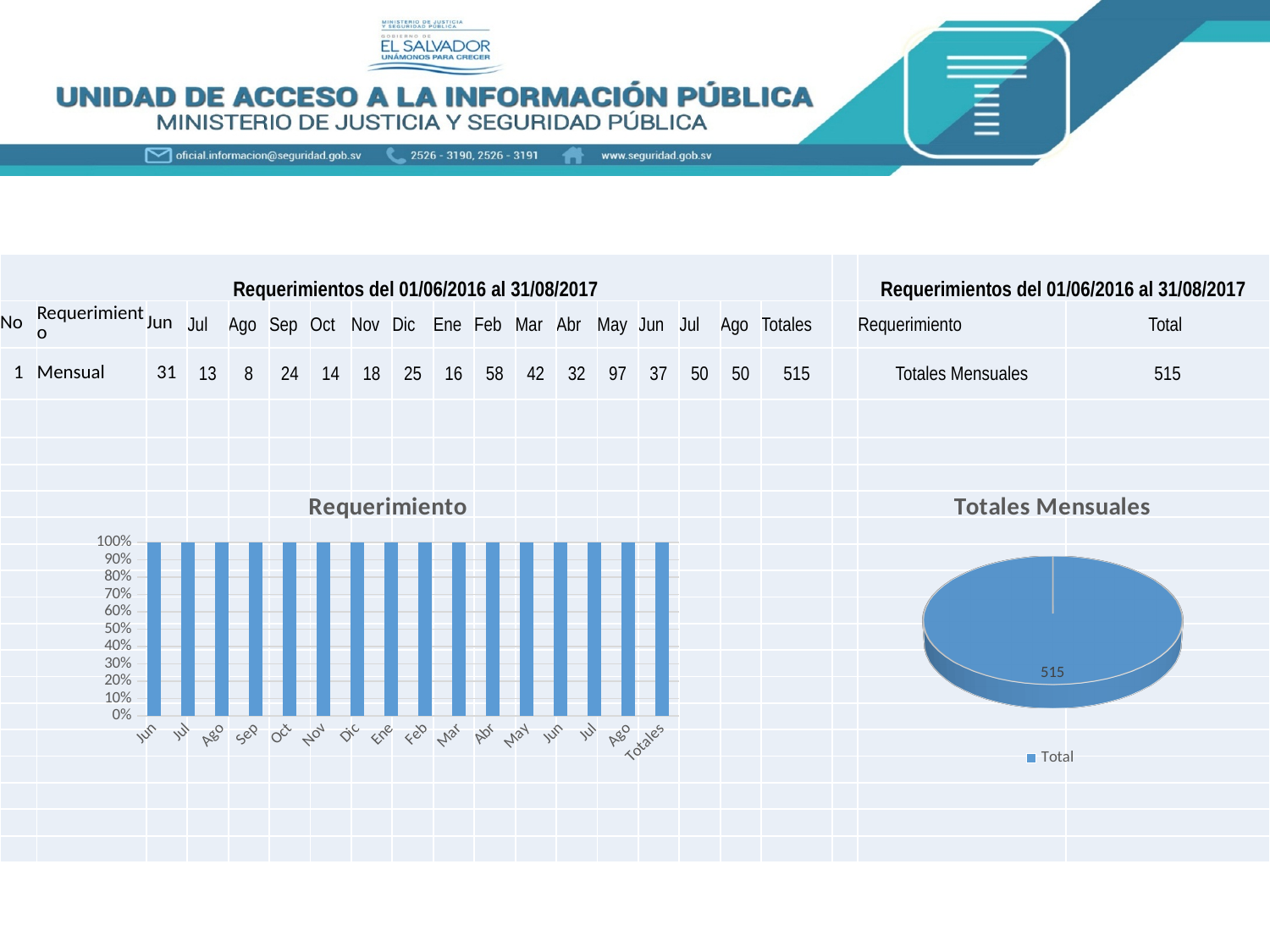
In the chart titled "Requerimiento", what is the highest value shown on the y axis? 100% In the chart titled "Totales Mensuales", what value is printed on the pie slice? 515 What kind of chart is the chart titled "Totales Mensuales"? pie chart What is the first category on the x axis of the chart titled "Requerimiento"? Jun In the chart titled "Requerimiento", is the value for Jun greater or less than 50%? greater How many slices does the pie chart titled "Totales Mensuales" have? 1 In the chart titled "Requerimiento", is the value for Totales greater or less than 90%? greater In the chart titled "Totales Mensuales", what share of the pie does the slice labelled 515 represent? 100% How many categories are shown on the x axis of the chart titled "Requerimiento"? 16 How many series does the legend of the chart titled "Totales Mensuales" list? 1 What is the legend entry of the chart titled "Totales Mensuales"? Total What kind of chart is the chart titled "Requerimiento"? bar chart